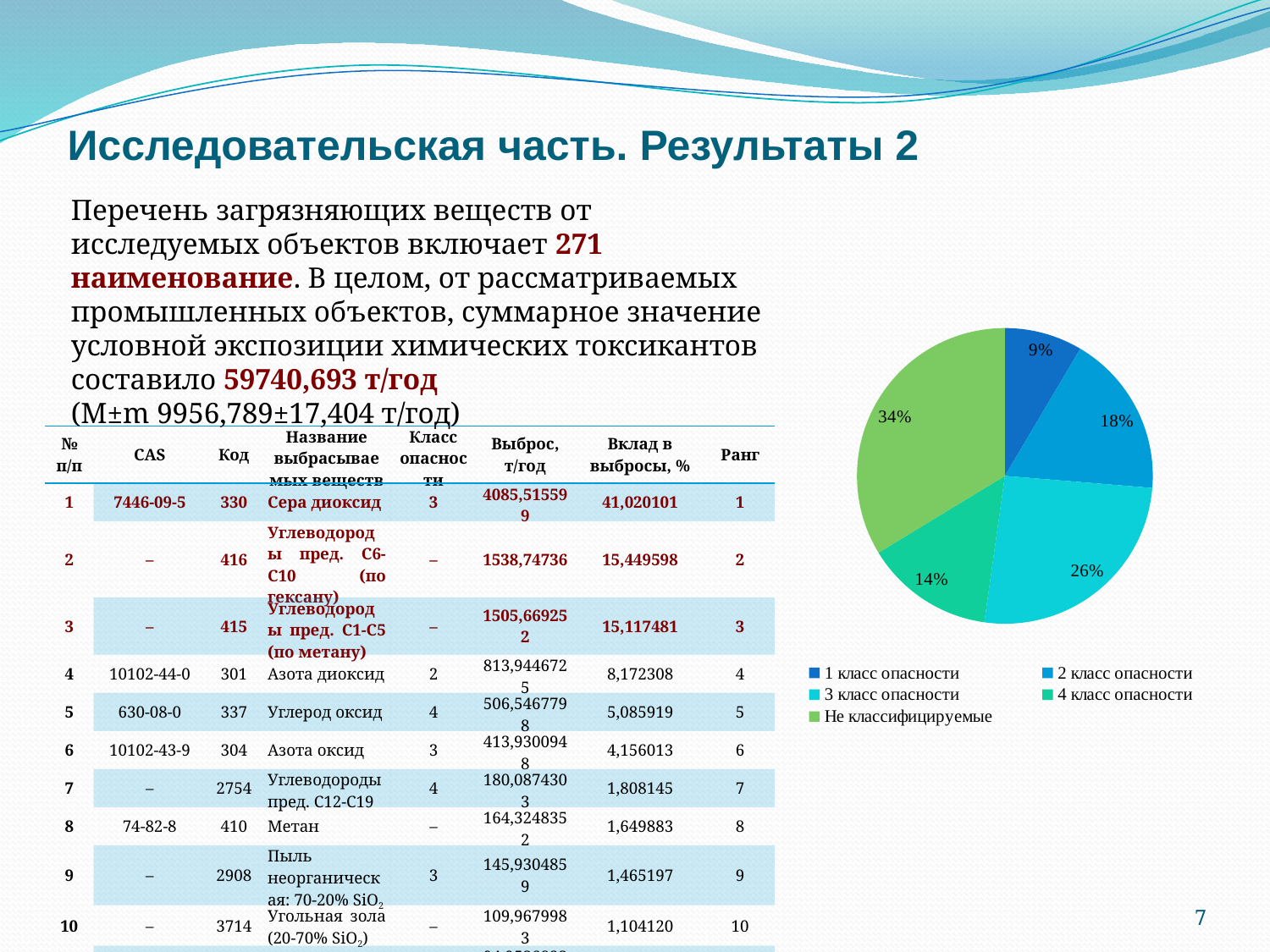
How many slices does the pie chart have? 5 How many entries does the legend of the pie chart list? 5 Which slice is larger in the pie chart: "2 класс опасности" or "4 класс опасности"? 2 класс опасности What is the difference in percentage points between the "3 класс опасности" slice and the "4 класс опасности" slice? 12 Which category has the largest slice in the pie chart? Не классифицируемые What share of the pie chart is labelled "3 класс опасности"? 26% What kind of chart is shown on the slide? pie chart What share of the pie chart is labelled "Не классифицируемые"? 34% What share of the pie chart is labelled "2 класс опасности"? 18% Which category has the smallest slice in the pie chart? 1 класс опасности